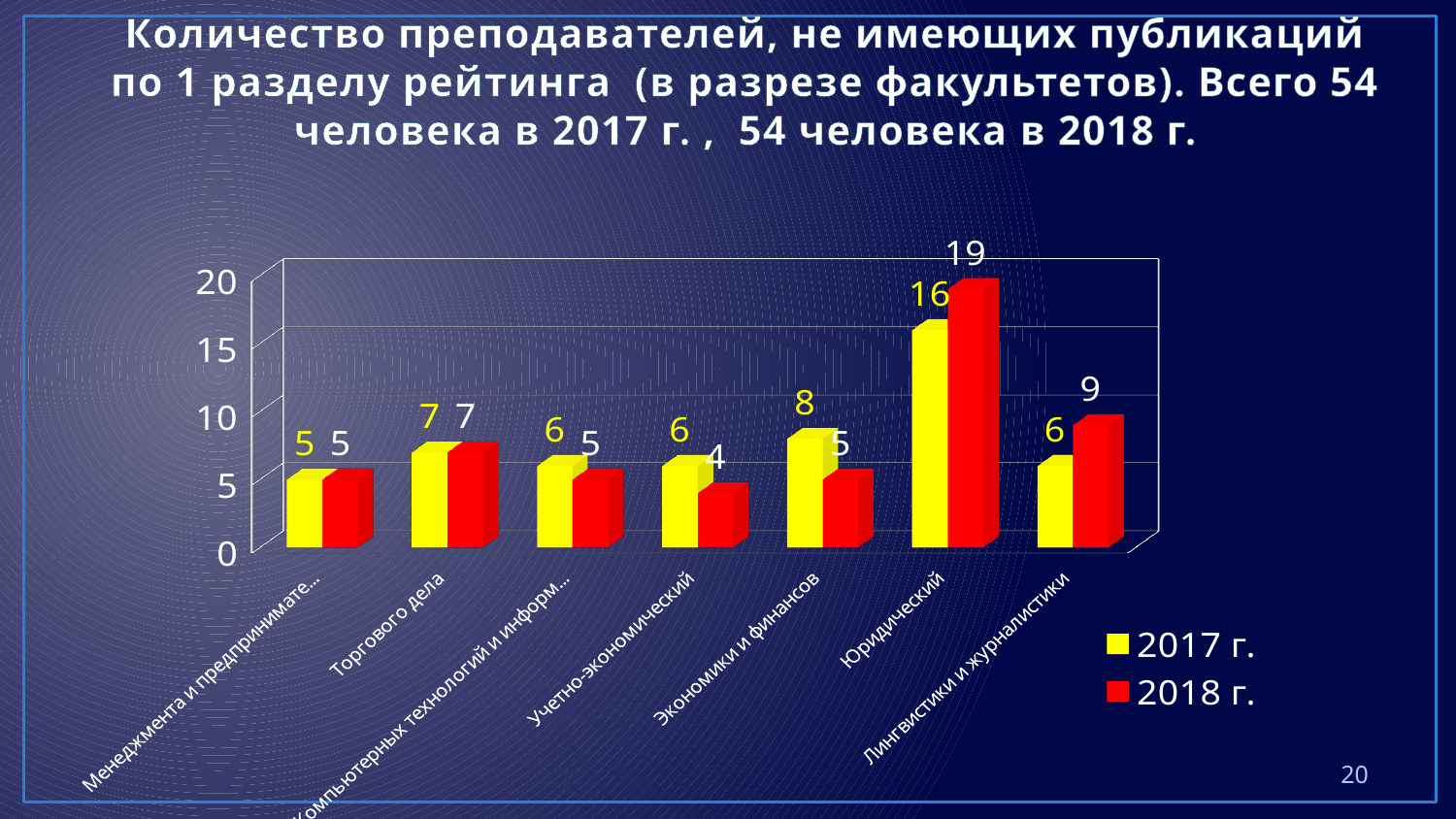
What is the difference between the 2018 г. and 2017 г. values for Юридический? 3 What is the value for Лингвистики и журналистики in 2018 г.? 9 For Экономики и финансов, which is larger: the 2017 г. value or the 2018 г. value? 2017 г. How many series does the legend list? 2 Which faculty has the lowest value in 2018 г.? Учетно-экономический What is the value for Юридический in 2017 г.? 16 What is the value for Экономики и финансов in 2017 г.? 8 How many faculties (categories) are shown on the x axis? 7 What kind of chart is shown on the slide? bar chart What is the value for Юридический in 2018 г.? 19 What is the value for Учетно-экономический in 2018 г.? 4 Which faculty has the highest value in 2018 г.? Юридический